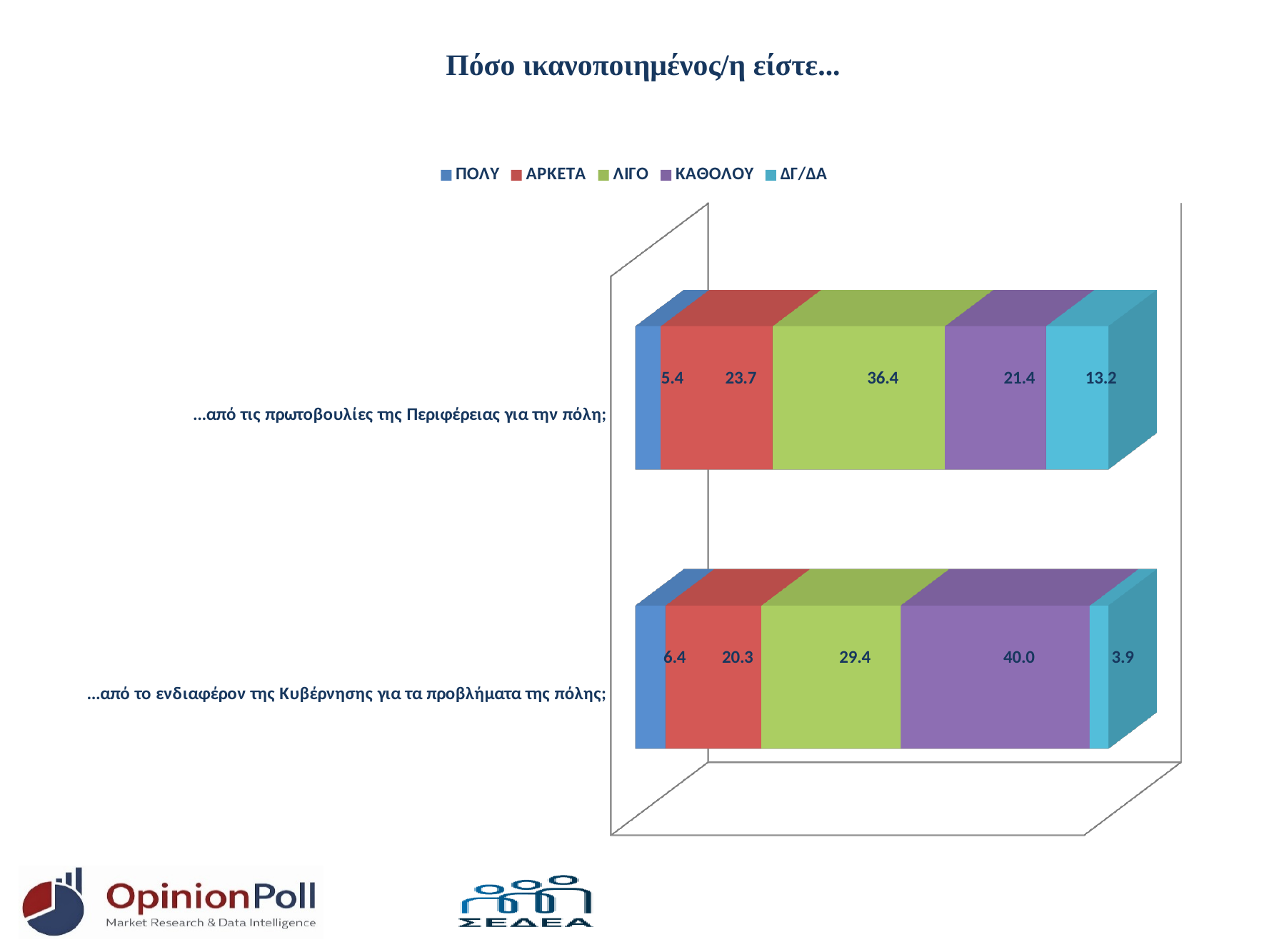
What kind of chart is shown on the slide? stacked bar chart What is the value for ΛΙΓΟ in the bar '...από τις πρωτοβουλίες της Περιφέρειας για την πόλη;'? 36.4 Which bar has the larger ΑΡΚΕΤΑ value: '...από τις πρωτοβουλίες της Περιφέρειας για την πόλη;' or '...από το ενδιαφέρον της Κυβέρνησης για τα προβλήματα της πόλης;'? ...από τις πρωτοβουλίες της Περιφέρειας για την πόλη; What is the value for ΔΓ/ΔΑ in the bar '...από το ενδιαφέρον της Κυβέρνησης για τα προβλήματα της πόλης;'? 3.9 Which series has the highest value in the bar '...από το ενδιαφέρον της Κυβέρνησης για τα προβλήματα της πόλης;'? ΚΑΘΟΛΟΥ What is the difference between the ΚΑΘΟΛΟΥ values of the two bars (40.0 and 21.4)? 18.6 Which series has the lowest value in the bar '...από τις πρωτοβουλίες της Περιφέρειας για την πόλη;'? ΠΟΛΥ What is the value for ΠΟΛΥ in the bar '...από τις πρωτοβουλίες της Περιφέρειας για την πόλη;'? 5.4 How many series does the legend list? 5 What is the value for ΚΑΘΟΛΟΥ in the bar '...από το ενδιαφέρον της Κυβέρνησης για τα προβλήματα της πόλης;'? 40.0 What is the title of the chart? Πόσο ικανοποιημένος/η είστε... How many categories (bars) are plotted in the chart? 2